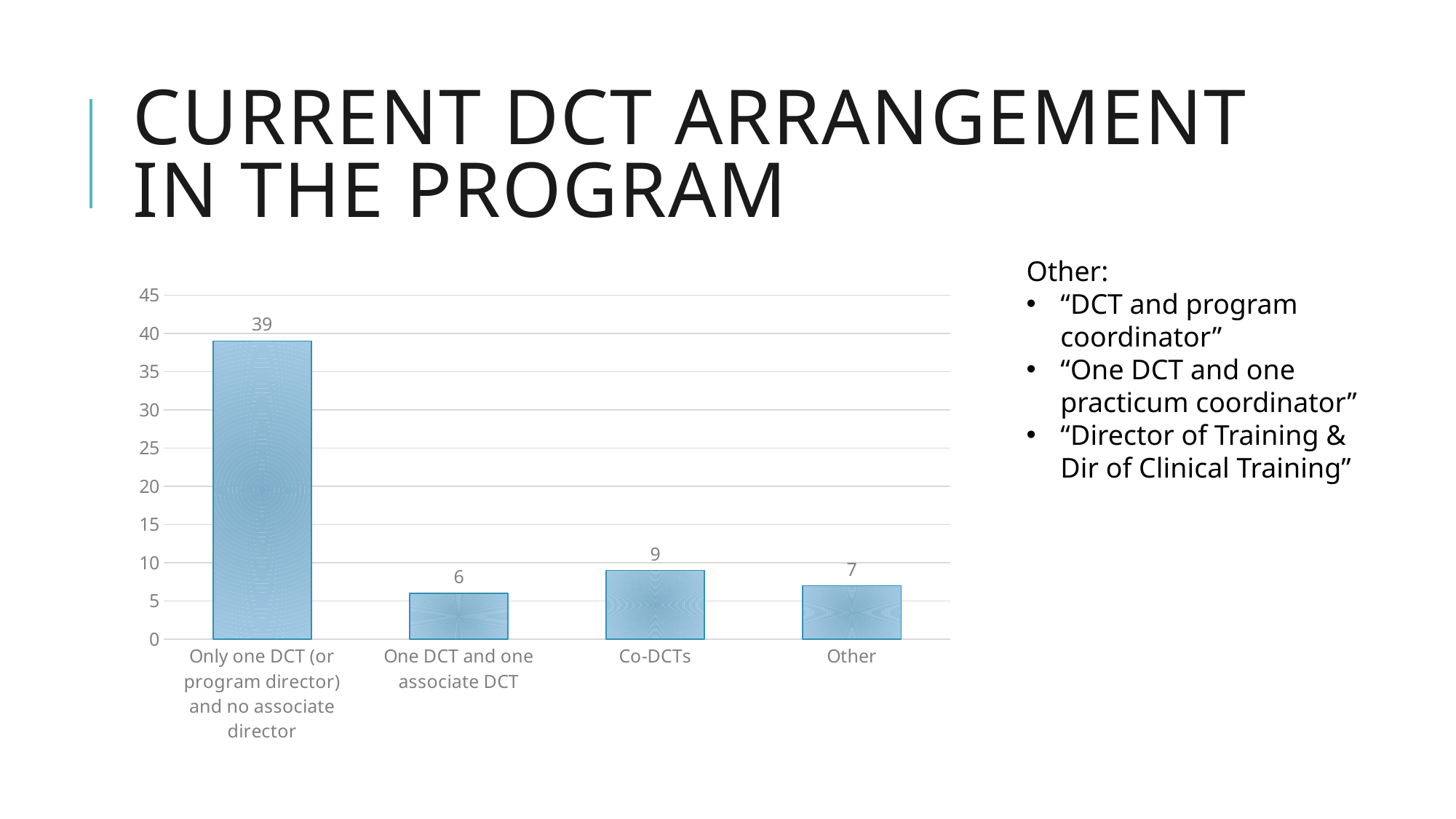
What is the difference between the values for "Only one DCT (or program director) and no associate director" and "Co-DCTs"? 30 Which category has the highest value? Only one DCT (or program director) and no associate director Which is larger, the value for "Co-DCTs" or the value for "Other"? Co-DCTs How many categories are shown on the x axis? 4 What is the value for "Only one DCT (or program director) and no associate director"? 39 Is the value for "Only one DCT (or program director) and no associate director" greater or less than 35? greater Which category has the lowest value? One DCT and one associate DCT What is the title of the slide containing the chart? Current DCT Arrangement in the Program What is the value for "One DCT and one associate DCT"? 6 What is the value for "Other"? 7 What is the value for "Co-DCTs"? 9 What kind of chart is shown on the slide? Bar chart